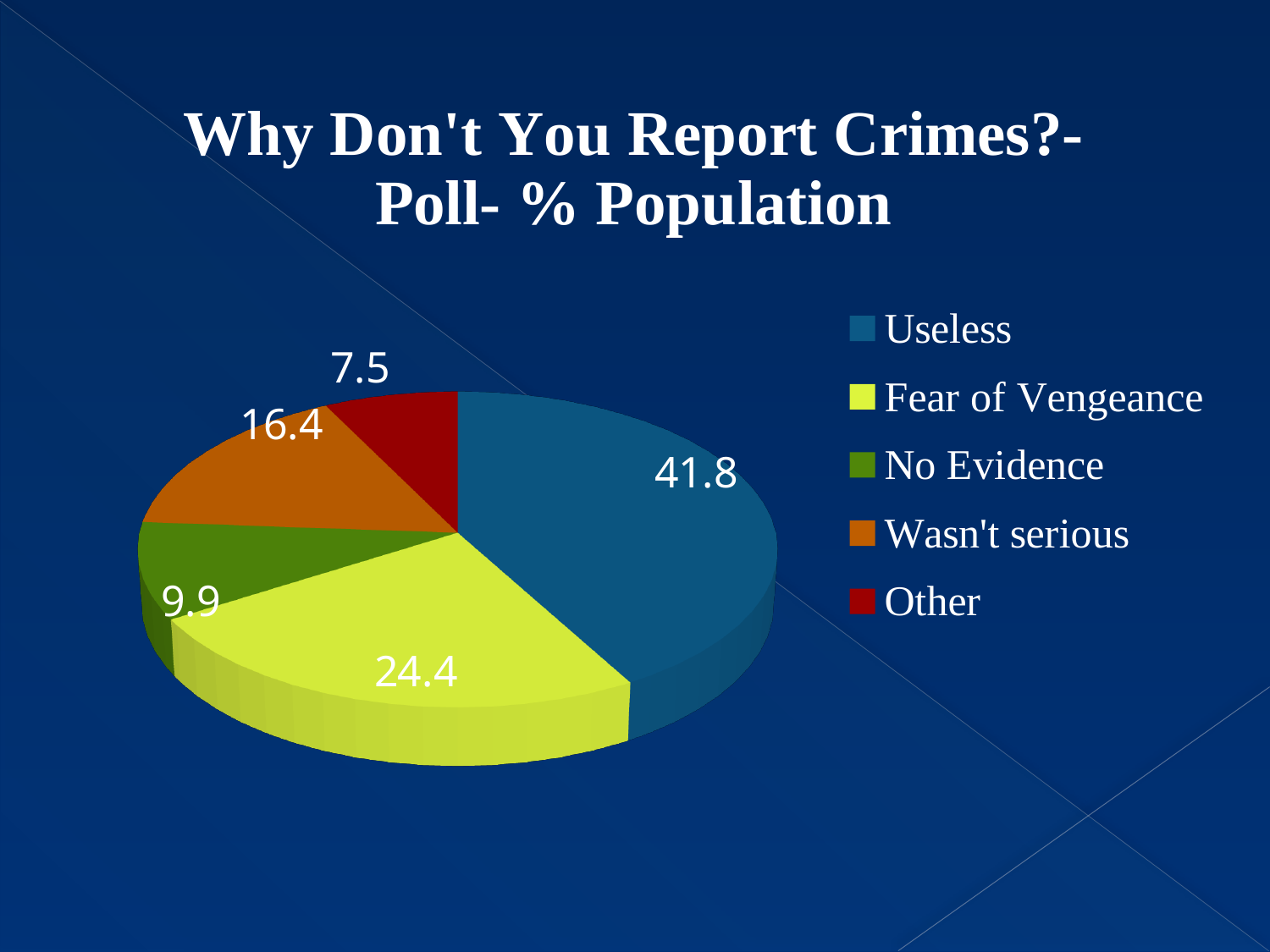
What kind of chart is shown on the slide? Pie chart How many categories does the legend list? 5 Which category has the largest slice? Useless What is the value for Wasn't serious? 16.4 Which category has the smallest slice? Other What is the title of the chart? Why Don't You Report Crimes?- Poll- % Population What is the value for No Evidence? 9.9 Which is larger, the value for Wasn't serious or the value for No Evidence? Wasn't serious What is the difference between the values for Useless and Fear of Vengeance? 17.4 What is the value for Fear of Vengeance? 24.4 What is the value for Useless? 41.8 What is the value for Other? 7.5